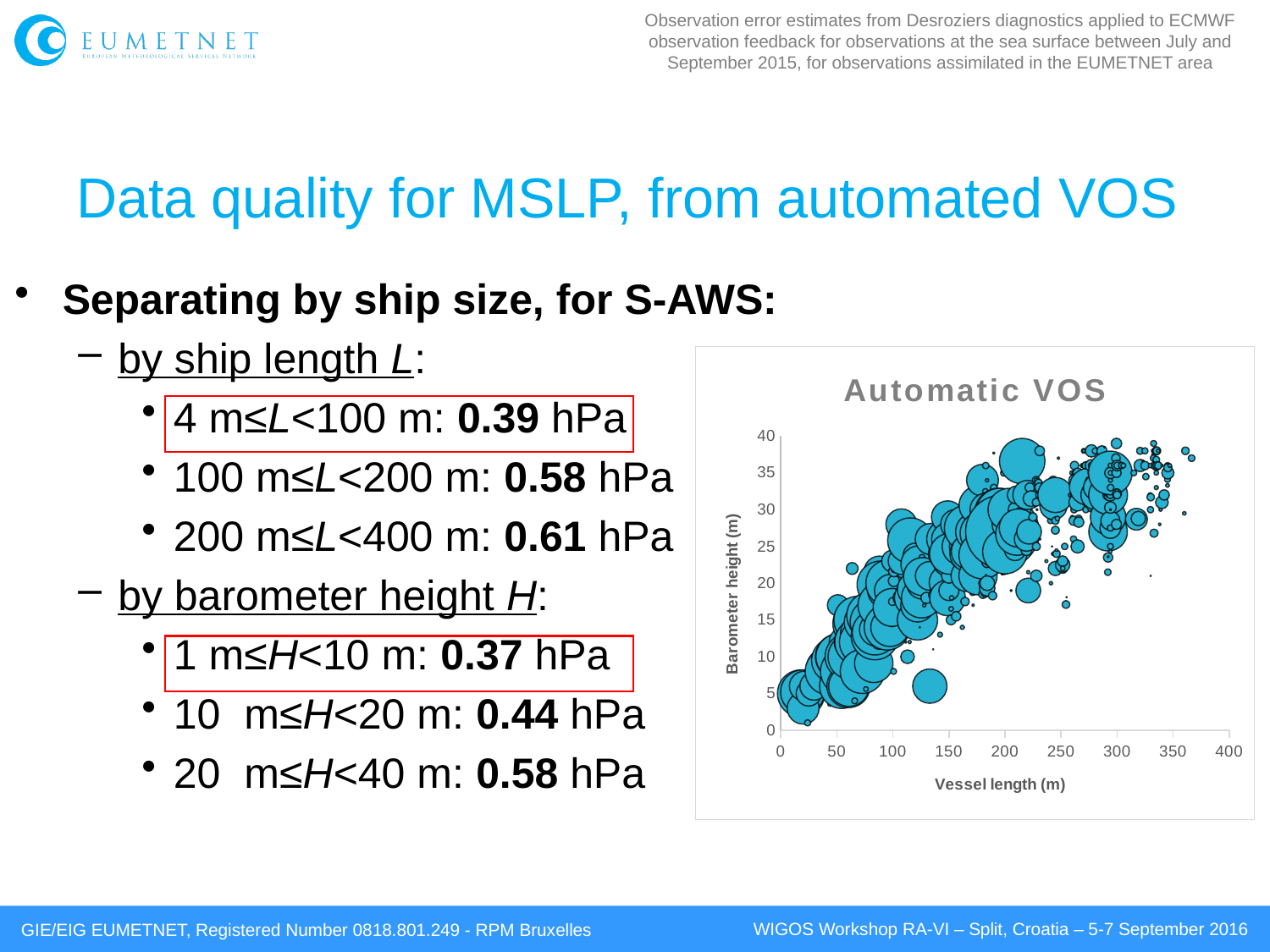
What quantity is plotted on the vertical axis of the chart? Barometer height (m) As vessel length increases along the x axis, does barometer height generally rise or fall? rise What kind of chart is shown on the slide? bubble chart What is the title of the chart on the slide? Automatic VOS